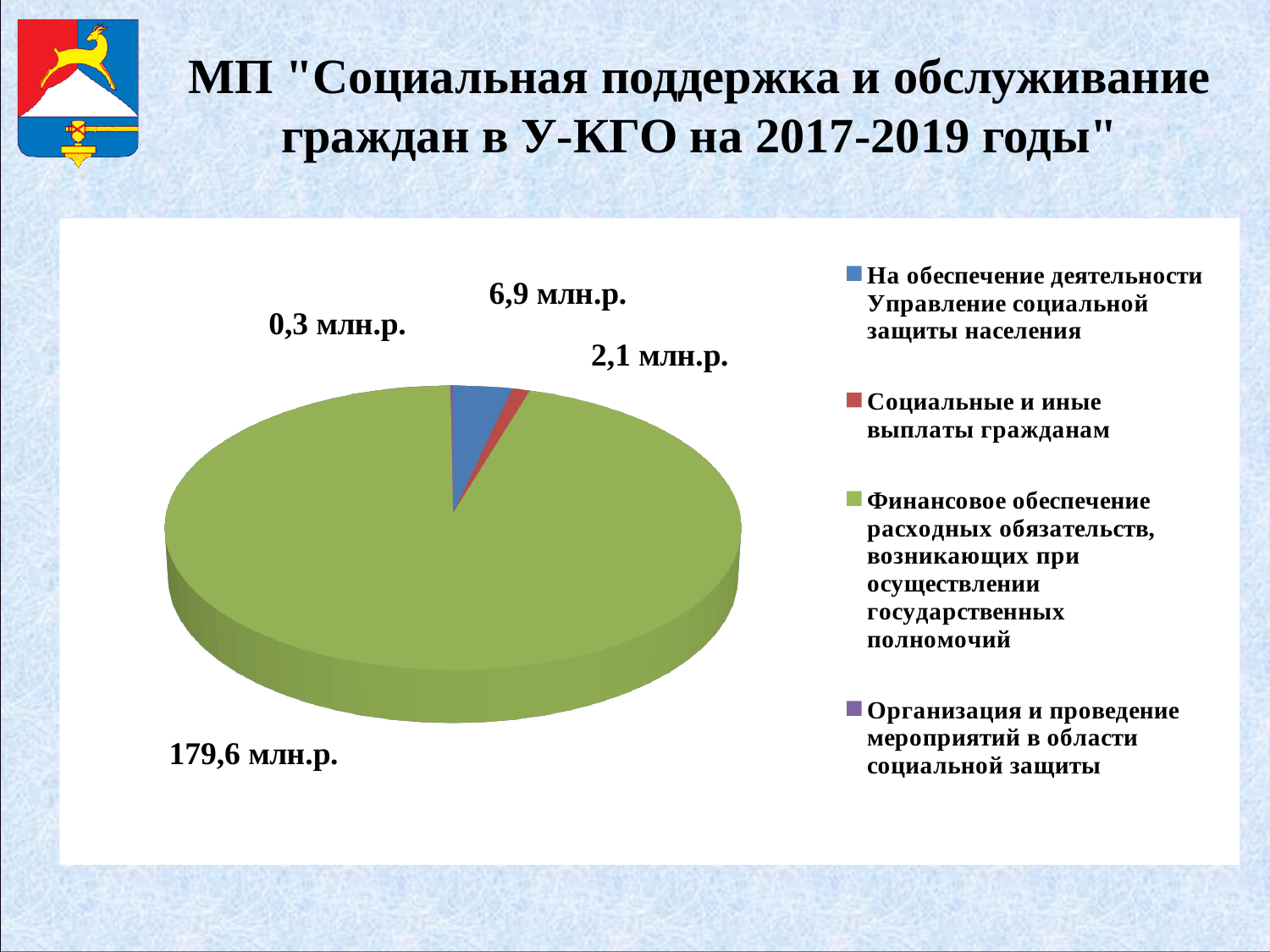
Which category has the largest slice of the pie? Финансовое обеспечение расходных обязательств, возникающих при осуществлении государственных полномочий What kind of chart is shown on the slide? Pie chart What is the value for "Финансовое обеспечение расходных обязательств, возникающих при осуществлении государственных полномочий"? 179,6 млн.р. Which category has the smallest value in the pie chart? Организация и проведение мероприятий в области социальной защиты What colour is the slice for "Социальные и иные выплаты гражданам"? Red Which is larger: the value for "На обеспечение деятельности Управление социальной защиты населения" or for "Социальные и иные выплаты гражданам"? На обеспечение деятельности Управление социальной защиты населения How many categories does the legend of the pie chart list? 4 What is the difference between the value for "На обеспечение деятельности Управление социальной защиты населения" and the value for "Социальные и иные выплаты гражданам"? 4,8 млн.р. What is the total of all four values shown on the pie chart? 188,9 млн.р. What is the value for "Социальные и иные выплаты гражданам"? 2,1 млн.р. What is the value for "На обеспечение деятельности Управление социальной защиты населения"? 6,9 млн.р. What is the value for "Организация и проведение мероприятий в области социальной защиты"? 0,3 млн.р.